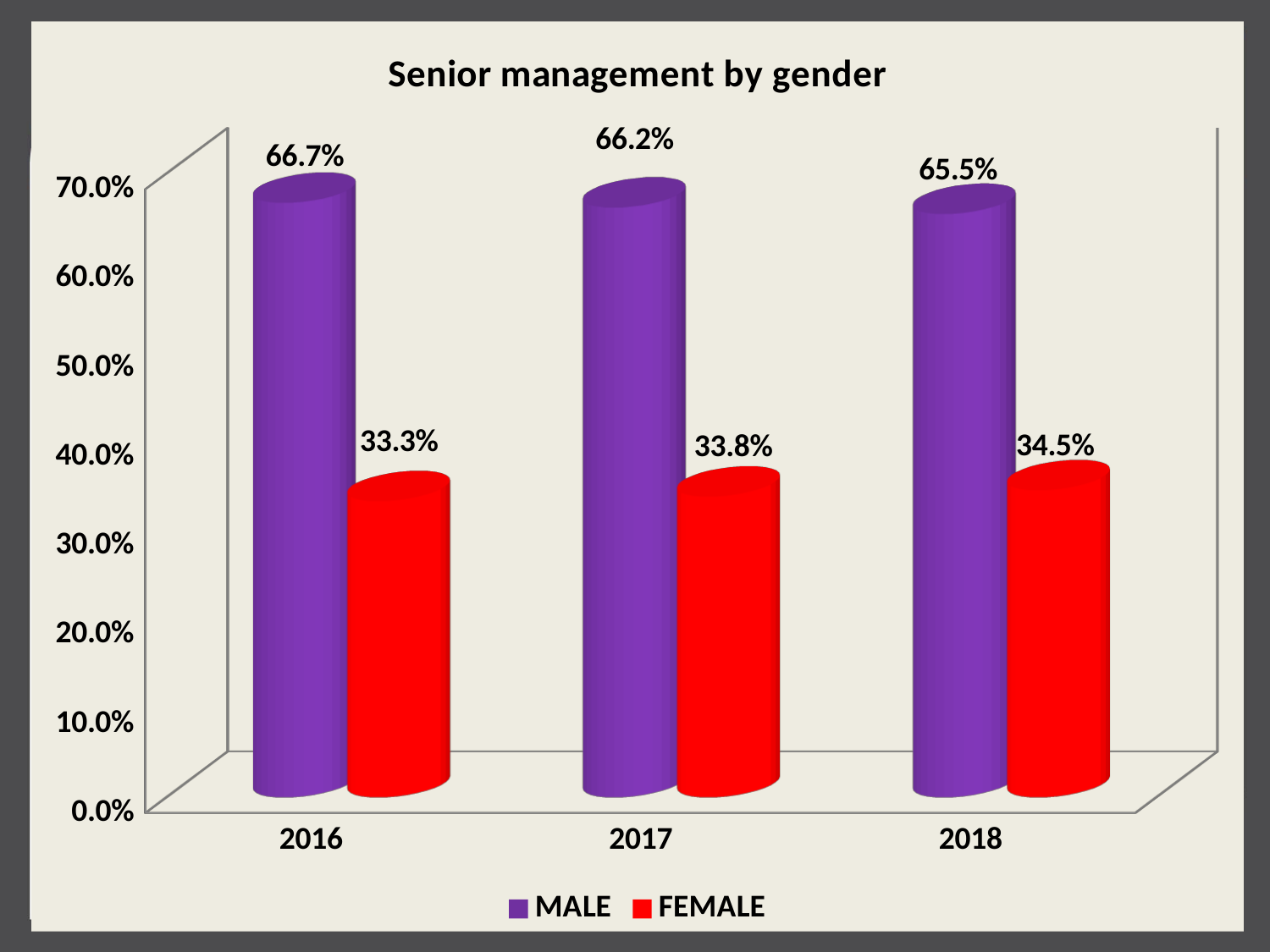
Does the MALE value rise or fall from 2016 to 2018? Fall What is the MALE value for 2017? 66.2% What kind of chart is shown? Bar chart In which year is the MALE value lowest? 2018 How many years are shown on the x axis? 3 What is the difference between the MALE and FEMALE values in 2016? 33.4% In which year is the FEMALE value highest? 2018 What is the MALE value for 2016? 66.7% What is the FEMALE value for 2018? 34.5% How many series does the legend list? 2 Which is larger in 2018, the MALE value or the FEMALE value? MALE What is the FEMALE value for 2017? 33.8%